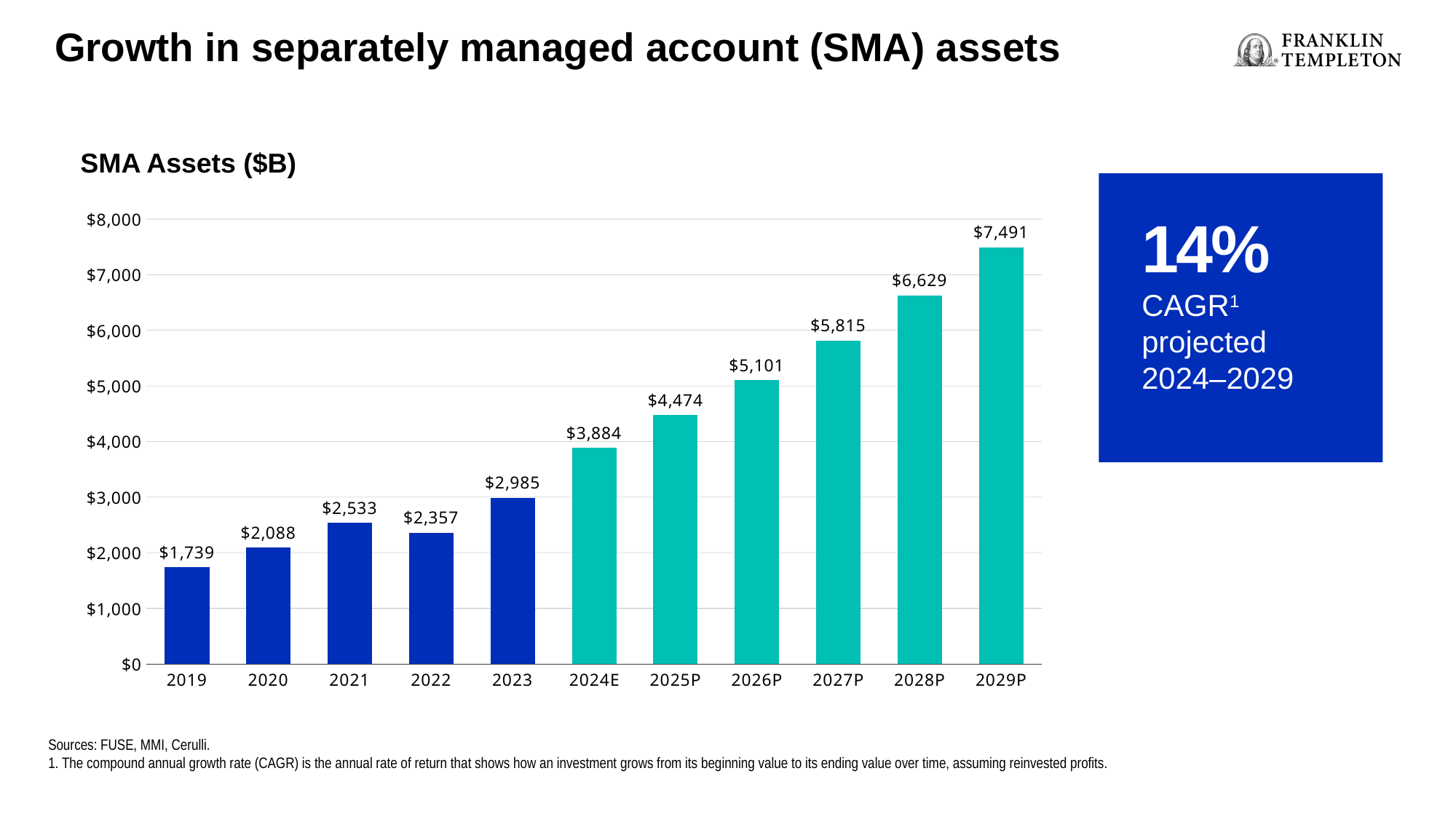
What kind of chart is used to show SMA assets? bar chart Which year has the lowest SMA assets value? 2019 What is the estimated value of SMA assets for 2024E? $3,884 Which year has the highest SMA assets value? 2029P Do SMA assets values generally rise or fall from 2019 to 2029P? rise What is the value of SMA assets for 2023? $2,985 Which is larger, the SMA assets value for 2021 or for 2022? 2021 Is the SMA assets value for 2027P greater or less than $6,000? less What is the difference between the SMA assets values for 2021 and 2022? $176 How many years are shown on the x axis of the chart? 11 What is the difference between the SMA assets values for 2029P and 2028P? $862 What is the projected value of SMA assets for 2029P? $7,491